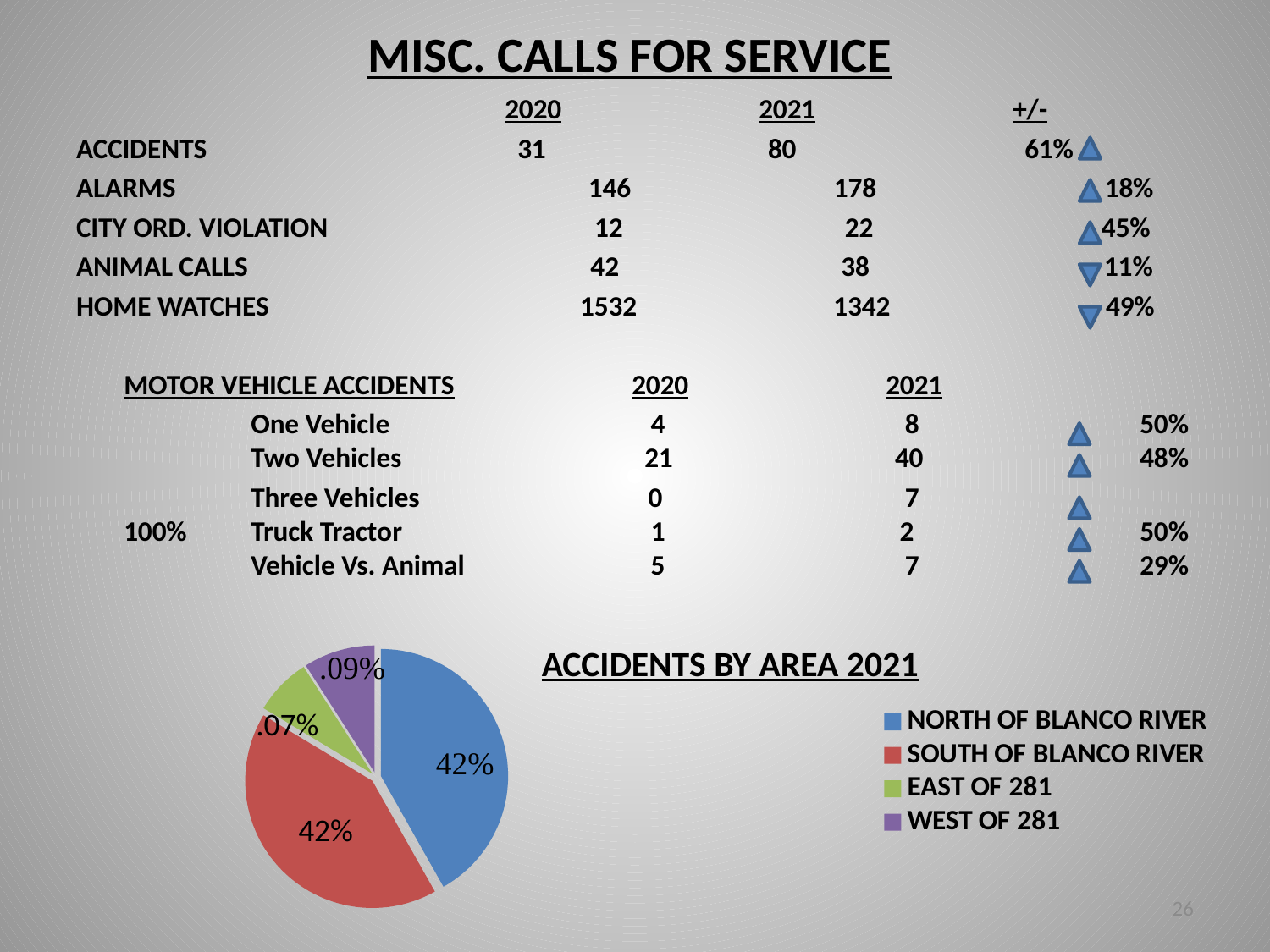
What is the title of the pie chart? ACCIDENTS BY AREA 2021 In the ACCIDENTS BY AREA 2021 pie chart, what share is labelled for NORTH OF BLANCO RIVER? 42% In the ACCIDENTS BY AREA 2021 pie chart, which slice is larger: EAST OF 281 or WEST OF 281? WEST OF 281 In the ACCIDENTS BY AREA 2021 pie chart, what colour is the NORTH OF BLANCO RIVER slice? blue In the ACCIDENTS BY AREA 2021 pie chart, which area has the smallest slice? EAST OF 281 In the ACCIDENTS BY AREA 2021 pie chart, what value is labelled for EAST OF 281? .07% In the ACCIDENTS BY AREA 2021 pie chart, what value is labelled for WEST OF 281? .09% What kind of chart is shown at the bottom of the slide? pie chart How many slices does the ACCIDENTS BY AREA 2021 pie chart have? 4 How many entries does the legend of the ACCIDENTS BY AREA 2021 pie chart list? 4 In the ACCIDENTS BY AREA 2021 pie chart, what share is labelled for SOUTH OF BLANCO RIVER? 42%